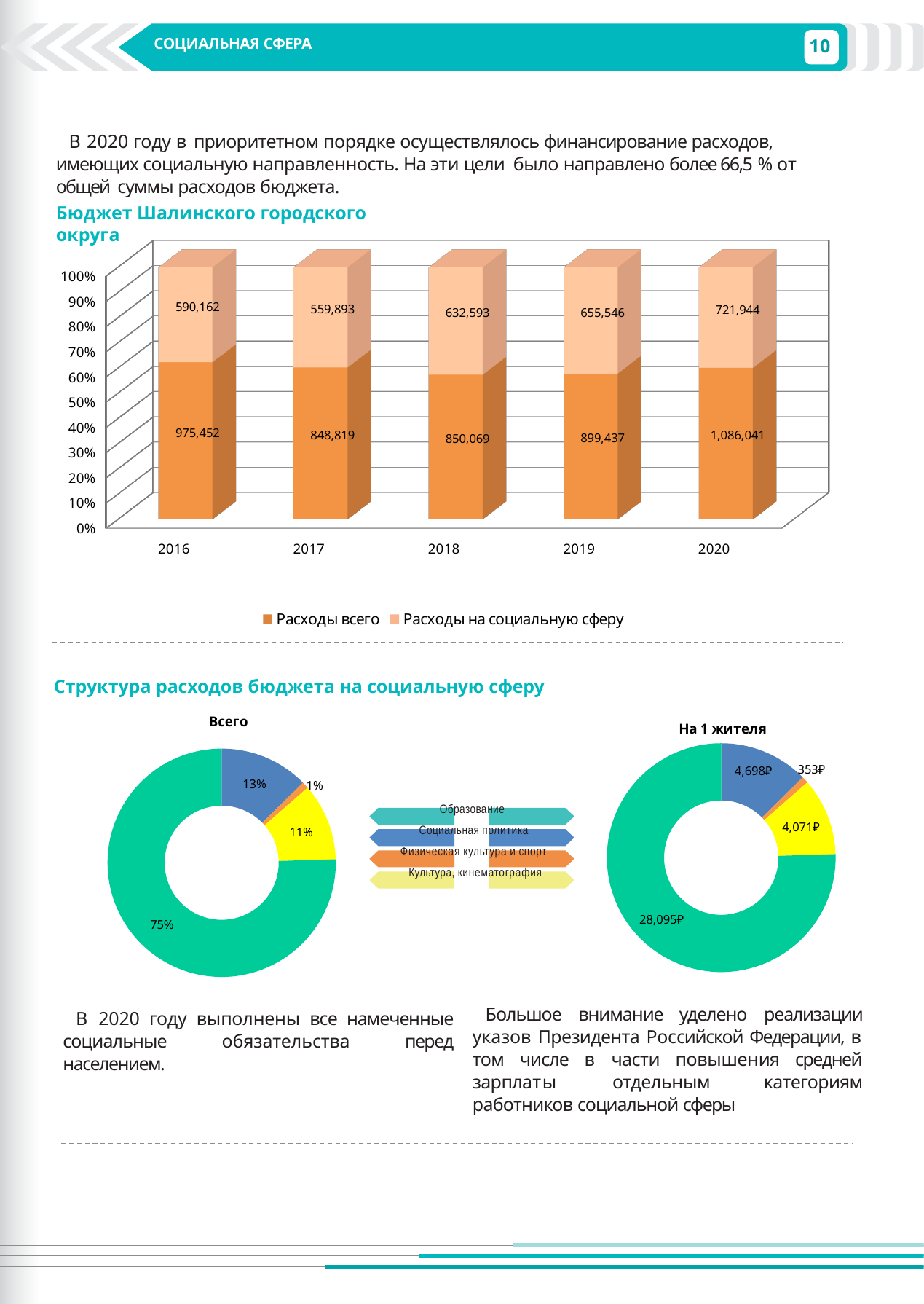
In the donut chart 'На 1 жителя', what is the value for 'Социальная политика' (the blue slice)? 4,698₽ How many series does the legend of the chart 'Бюджет Шалинского городского округа' list? 2 In the donut chart 'Всего', what share does the largest slice (Образование) have? 75% In the chart 'Бюджет Шалинского городского округа', which year has the highest value for 'Расходы всего'? 2020 In the chart 'Бюджет Шалинского городского округа', is 'Расходы всего' larger in 2016 or in 2017? 2016 In the chart 'Бюджет Шалинского городского округа', what is the value of 'Расходы на социальную сферу' for 2018? 632,593 What kind of chart is 'Бюджет Шалинского городского округа'? Stacked bar chart In the chart 'Бюджет Шалинского городского округа', which year has the lowest value for 'Расходы на социальную сферу'? 2017 In the chart 'Бюджет Шалинского городского округа', what is the value of 'Расходы всего' for 2020? 1,086,041 In the donut chart 'На 1 жителя', which category has the smallest value? Физическая культура и спорт How many years are shown on the x axis of the chart 'Бюджет Шалинского городского округа'? 5 In the chart 'Бюджет Шалинского городского округа', what is the difference between 'Расходы всего' in 2020 and in 2019? 186,604